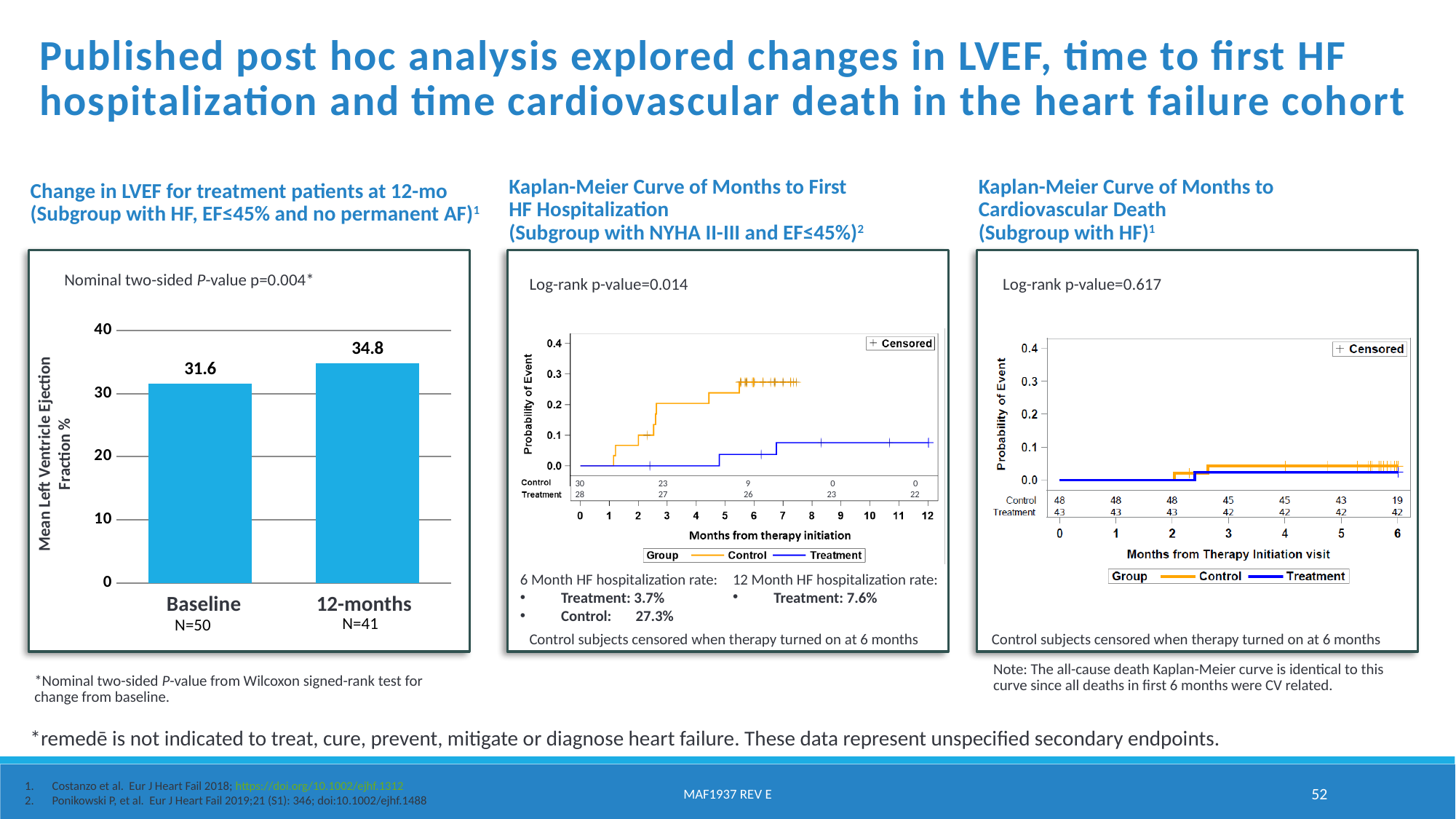
In the 'Change in LVEF for treatment patients at 12-mo' chart, what is the mean left ventricle ejection fraction at 12-months? 34.8 In the 'Kaplan-Meier Curve of Months to First HF Hospitalization' chart, how many groups does the legend list? 2 What kind of chart is the 'Change in LVEF for treatment patients at 12-mo' chart? Bar chart In the 'Change in LVEF for treatment patients at 12-mo' chart, what is the difference between the 12-months value and the Baseline value? 3.2 In the 'Change in LVEF for treatment patients at 12-mo' chart, how many categories are plotted? 2 In the 'Change in LVEF for treatment patients at 12-mo' chart, which category has the higher value, Baseline or 12-months? 12-months In the 'Change in LVEF for treatment patients at 12-mo' chart, do the values rise or fall from Baseline to 12-months? Rise In the 'Kaplan-Meier Curve of Months to First HF Hospitalization' chart, is the Control probability of event at month 6 greater or less than 0.2? greater In the 'Kaplan-Meier Curve of Months to Cardiovascular Death' chart, what colour is the Treatment line? Blue In the 'Kaplan-Meier Curve of Months to First HF Hospitalization' chart, which group has the higher probability of event at month 6, Control or Treatment? Control In the 'Kaplan-Meier Curve of Months to First HF Hospitalization' chart, is the Treatment probability of event at month 12 greater or less than 0.1? less In the 'Change in LVEF for treatment patients at 12-mo' chart, what is the mean left ventricle ejection fraction at Baseline? 31.6